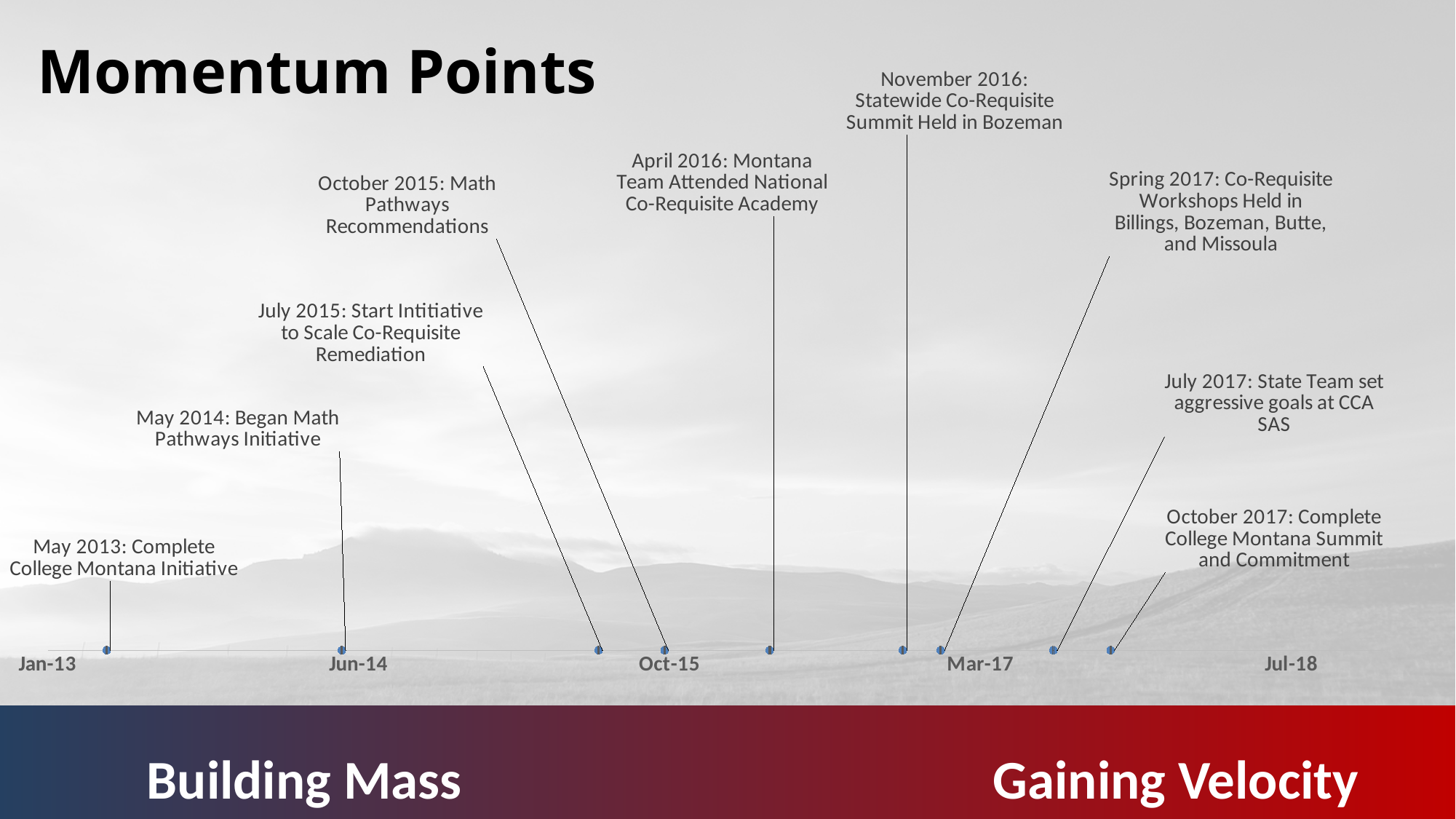
What event is marked at May 2013 on the timeline? Complete College Montana Initiative What is the first date label shown on the x axis of the timeline? Jan-13 What event is marked at May 2014 on the timeline? Began Math Pathways Initiative What is the title of the chart on the slide? Momentum Points What event is marked at November 2016 on the timeline? Statewide Co-Requisite Summit Held in Bozeman What is the last date label shown on the x axis of the timeline? Jul-18 Which event is the latest on the timeline? October 2017: Complete College Montana Summit and Commitment How many momentum points are plotted on the timeline? 9 In which month and year did the Math Pathways Recommendations occur according to the timeline? October 2015 What event is marked at April 2016 on the timeline? Montana Team Attended National Co-Requisite Academy Which occurred earlier: the Start Initiative to Scale Co-Requisite Remediation or the Math Pathways Recommendations? Start Initiative to Scale Co-Requisite Remediation Which event is the earliest on the timeline? May 2013: Complete College Montana Initiative